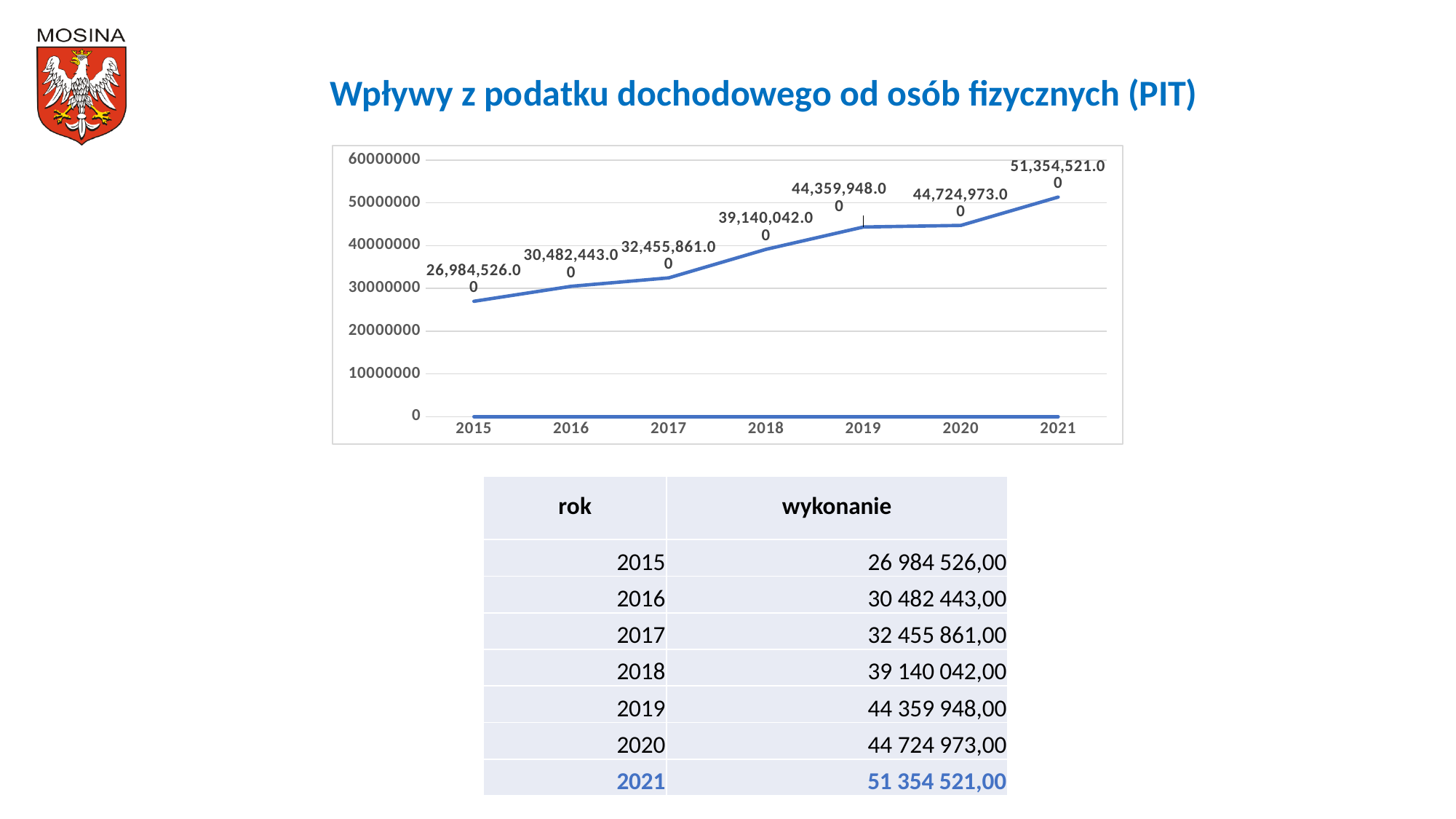
What is the difference between the values for 2016 and 2015? 3,497,917.00 What kind of chart is shown on the slide? line chart What is the difference between the values for 2021 and 2020? 6,629,548.00 Which year has the lowest value? 2015 Which year has the highest value? 2021 What is the value plotted for 2015? 26,984,526.00 What is the value plotted for 2018? 39,140,042.00 How many years are plotted on the x axis? 7 What is the value plotted for 2021? 51,354,521.00 Which is larger, the value for 2017 or the value for 2018? 2018 Do the values rise or fall from 2015 to 2021? rise What is the title of the chart? Wpływy z podatku dochodowego od osób fizycznych (PIT)